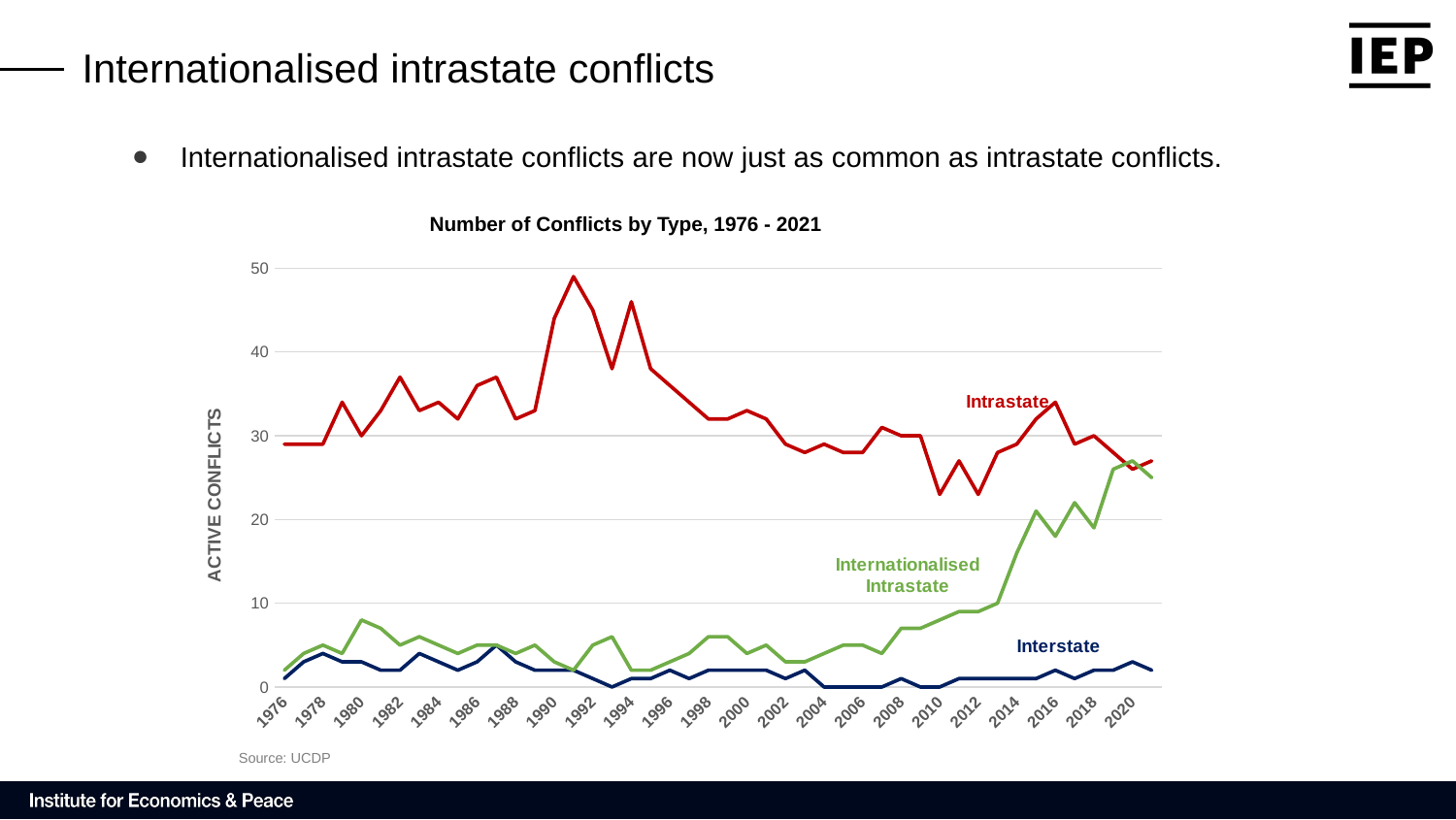
Is the value for Internationalised Intrastate conflicts in 2020 greater or less than 20? greater What is the title of the chart? Number of Conflicts by Type, 1976 - 2021 Is the value for Internationalised Intrastate conflicts in 2000 greater or less than 10? less Is the value for Intrastate conflicts in 2010 greater or less than 30? less Which series has the highest value in 1990? Intrastate What is the label on the vertical axis of the chart? ACTIVE CONFLICTS Does the Internationalised Intrastate line rise or fall between 2010 and 2020? rise How many series are plotted in the chart? 3 What kind of chart is shown on the slide? line chart Which series has the lowest value in 2018? Interstate